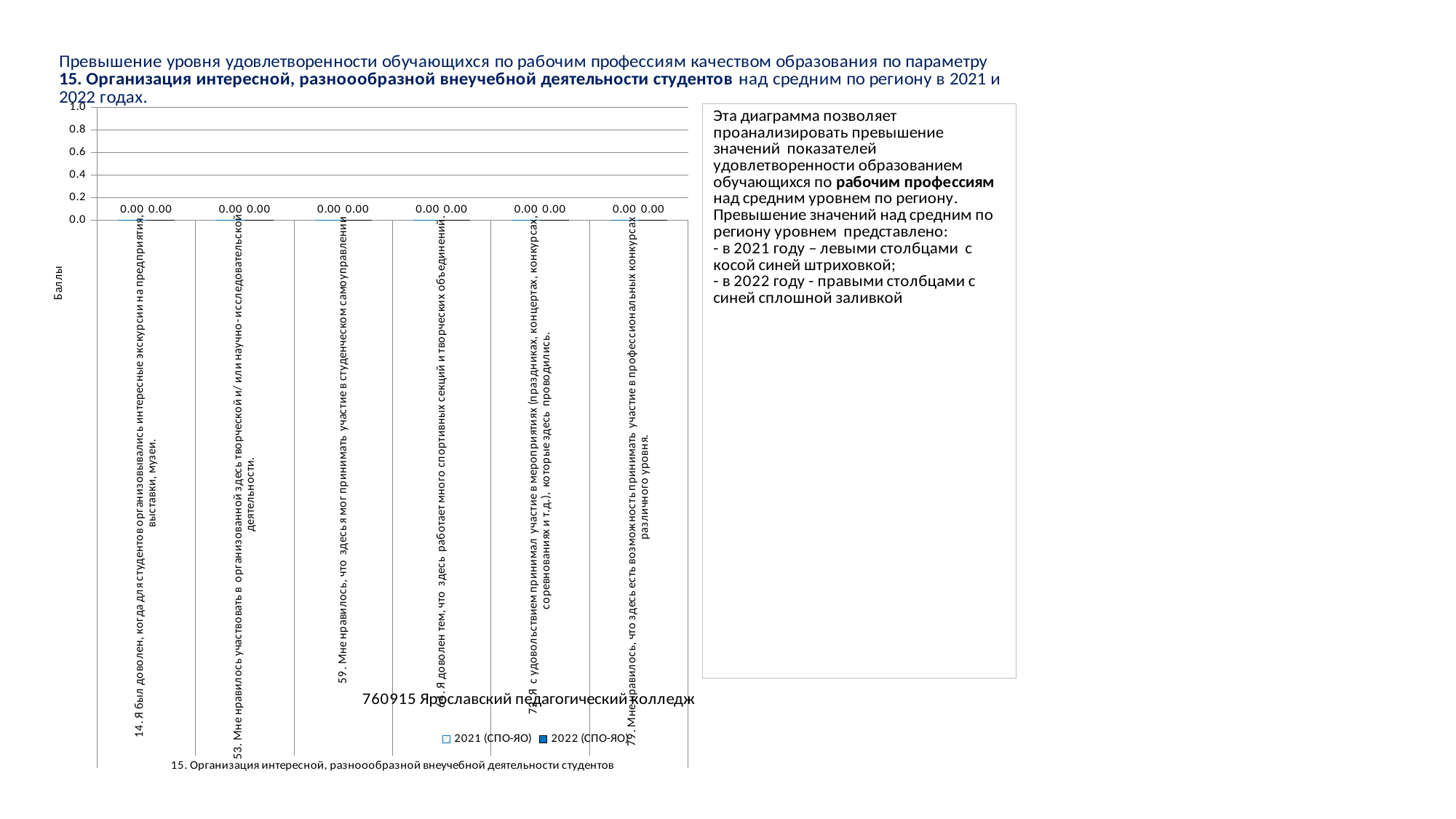
What are the two series names listed in the legend? 2021 (СПО-ЯО) and 2022 (СПО-ЯО) What is the value for 2022 (СПО-ЯО) for category 59 (Мне нравилось, что здесь я мог принимать участие в студенческом самоуправлении)? 0.00 What is the value for 2022 (СПО-ЯО) for category 53 (Мне нравилось участвовать в организованной здесь творческой и/или научно-исследовательской деятельности)? 0.00 What is the highest tick value shown on the vertical axis? 1.0 What is the value for 2021 (СПО-ЯО) for category 79 (Мне нравилось, что здесь есть возможность принимать участие в профессиональных конкурсах различного уровня)? 0.00 What kind of chart is shown on the slide? bar chart What is the value for 2021 (СПО-ЯО) for category 14 (Я был доволен, когда для студентов организовывались интересные экскурсии на предприятия, выставки, музеи)? 0.00 How many series does the legend list? 2 How many categories are shown on the x axis of the chart? 6 What is the label of the vertical axis of the chart? Баллы